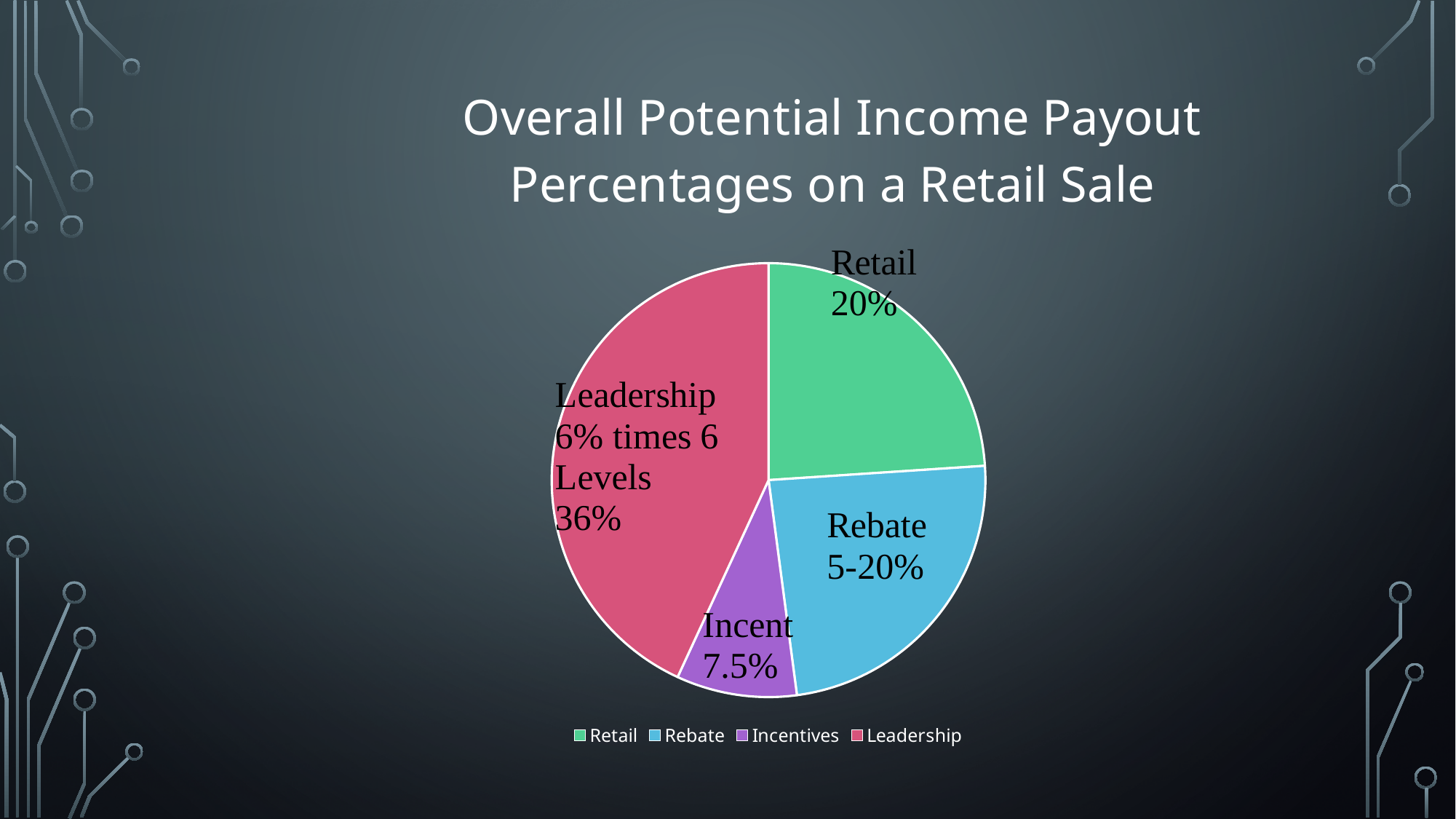
Which is larger, the Retail slice or the Incentives slice? Retail How many entries does the legend list? 4 What range is printed on the Rebate slice? 5-20% What percentage is shown for the Retail slice? 20% What is the title of the chart? Overall Potential Income Payout Percentages on a Retail Sale What percentage is shown for the Incentives (Incent) slice? 7.5% What percentage is shown for the Leadership slice? 36% What is the difference between the Leadership percentage and the Retail percentage? 16 percentage points What kind of chart is shown on the slide? Pie chart Which slice is the largest in the pie chart? Leadership How many slices does the pie chart have? 4 Which slice is the smallest in the pie chart? Incentives